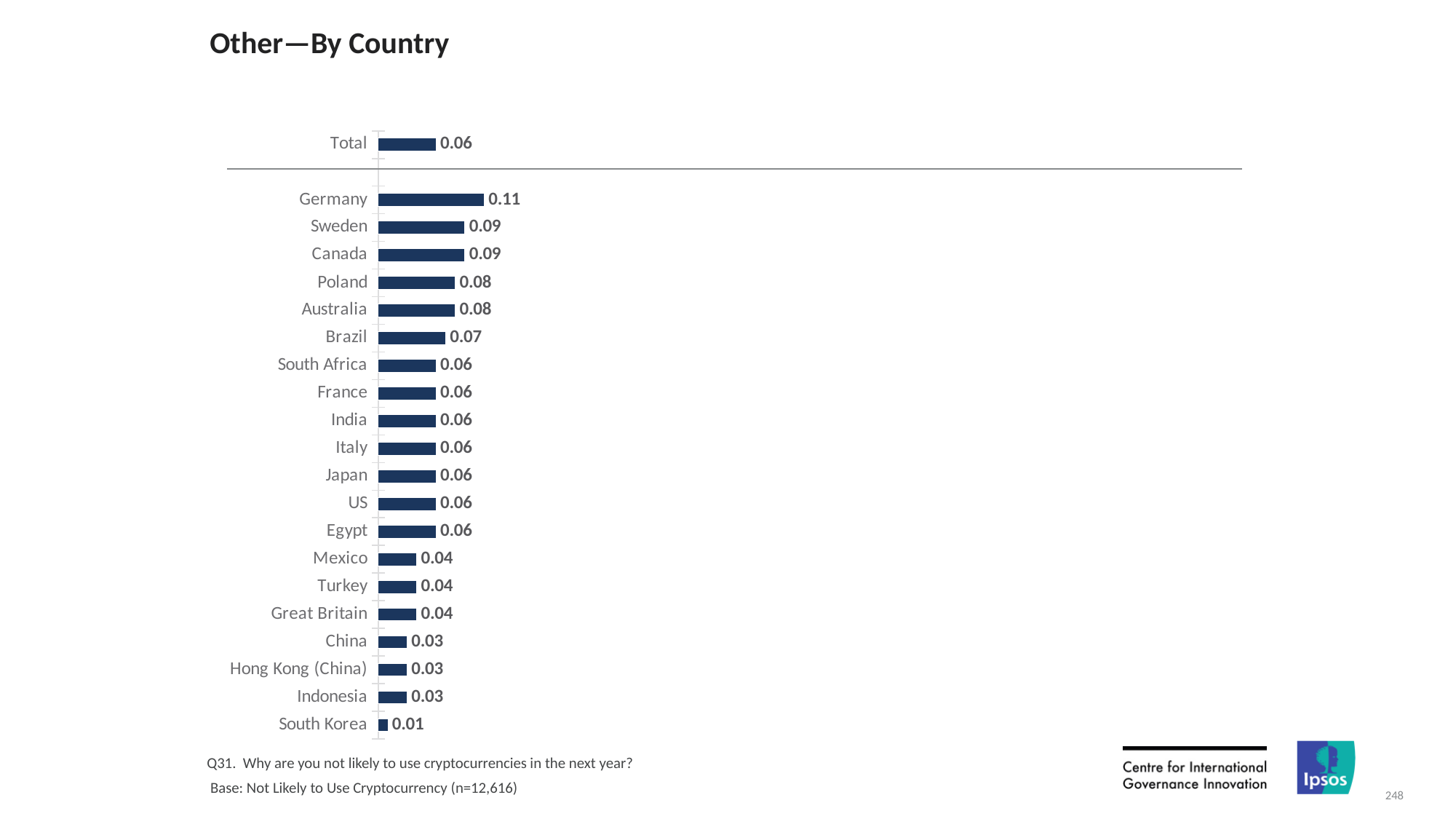
What is the value for Germany? 0.11 What is the difference between the values for Poland and Great Britain? 0.04 What is the difference between the values for Germany and South Korea? 0.10 Which country has the lowest value? South Korea Which country has the highest value? Germany What is the value for South Korea? 0.01 What is the value for Total? 0.06 How many countries are listed below the Total bar? 20 What is the title of the chart? Other—By Country What is the value for Mexico? 0.04 Which is larger, the value for Brazil or the value for China? Brazil What kind of chart is shown on the slide? Bar chart